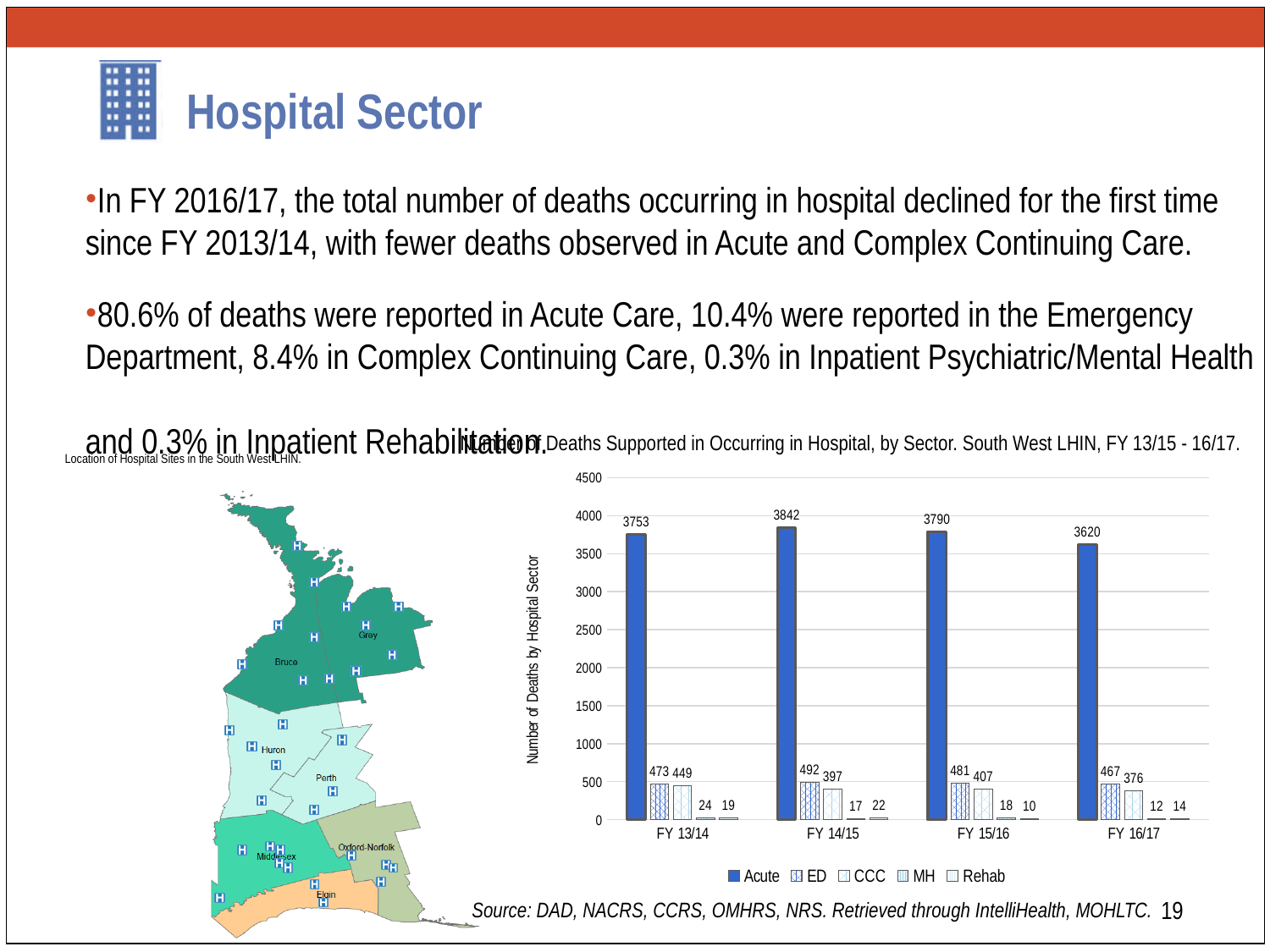
Which is larger, the MH value in FY 13/14 or the MH value in FY 16/17? FY 13/14 How many series does the legend list? 5 In which fiscal year is the Acute value highest? FY 14/15 What is the value for CCC in FY 16/17? 376 Does the CCC value rise or fall from FY 14/15 to FY 16/17? fall What is the value for ED in FY 15/16? 481 In which fiscal year is the Rehab value lowest? FY 15/16 What is the value for Acute in FY 14/15? 3842 What kind of chart is shown on the slide? bar chart What is the difference between the Acute values for FY 15/16 and FY 16/17? 170 What is the value for Rehab in FY 13/14? 19 How many fiscal years are shown on the x axis? 4